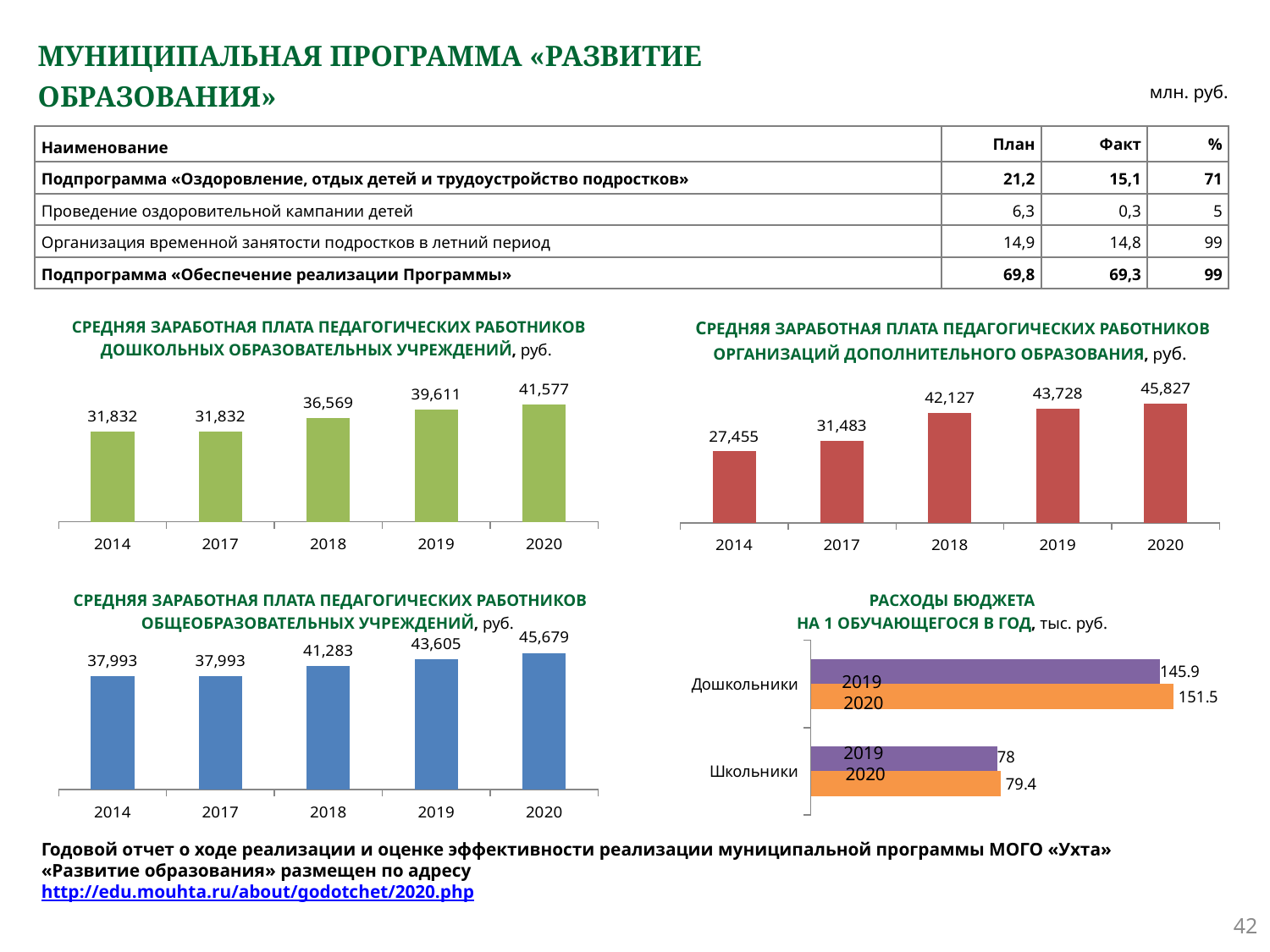
In the chart 'Средняя заработная плата педагогических работников дошкольных образовательных учреждений', how many years are shown on the x axis? 5 In the chart 'Средняя заработная плата педагогических работников дошкольных образовательных учреждений', what is the value for 2020? 41,577 In the chart 'Средняя заработная плата педагогических работников организаций дополнительного образования', which year has the lowest value? 2014 In the chart 'Средняя заработная плата педагогических работников дошкольных образовательных учреждений', what is the difference between the 2020 and 2014 values? 9,745 In the chart 'Средняя заработная плата педагогических работников организаций дополнительного образования', do the values rise or fall from 2014 to 2020? rise In the chart 'Расходы бюджета на 1 обучающегося в год', what is the 2020 value for Дошкольники? 151.5 In the chart 'Расходы бюджета на 1 обучающегося в год', what is the difference between the 2020 and 2019 values for Школьники? 1.4 In the chart 'Средняя заработная плата педагогических работников общеобразовательных учреждений', which year has the highest value? 2020 In the chart 'Средняя заработная плата педагогических работников общеобразовательных учреждений', which is larger: the value for 2018 or the value for 2017? 2018 In the chart 'Средняя заработная плата педагогических работников общеобразовательных учреждений', what is the value for 2019? 43,605 What type of chart is 'Расходы бюджета на 1 обучающегося в год'? bar chart In the chart 'Средняя заработная плата педагогических работников организаций дополнительного образования', what is the value for 2018? 42,127